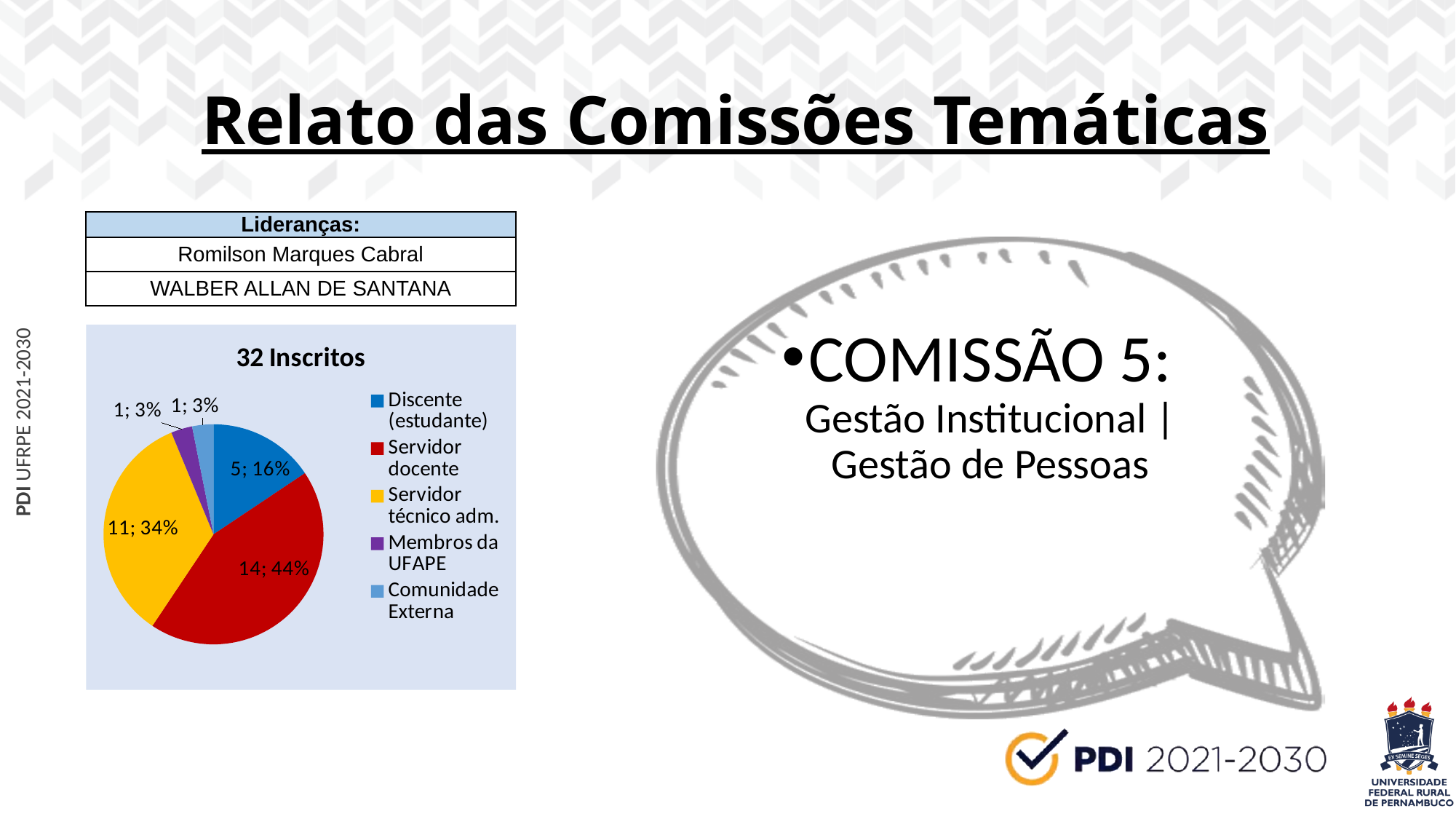
What percentage of the pie does Servidor técnico adm. represent? 34% What percentage share does Membros da UFAPE have? 3% What type of chart is shown on the slide? pie chart What is the title of the pie chart? 32 Inscritos Which category has the largest slice of the pie? Servidor docente Which is larger, the Discente (estudante) slice or the Servidor técnico adm. slice? Servidor técnico adm. What is the difference between the Servidor docente count and the Servidor técnico adm. count? 3 What is the count for Discente (estudante)? 5 How many slices does the pie chart have? 5 Which colour represents Comunidade Externa in the pie chart? light blue How many inscritos are in the Servidor docente category? 14 How many entries does the legend of the pie chart list? 5